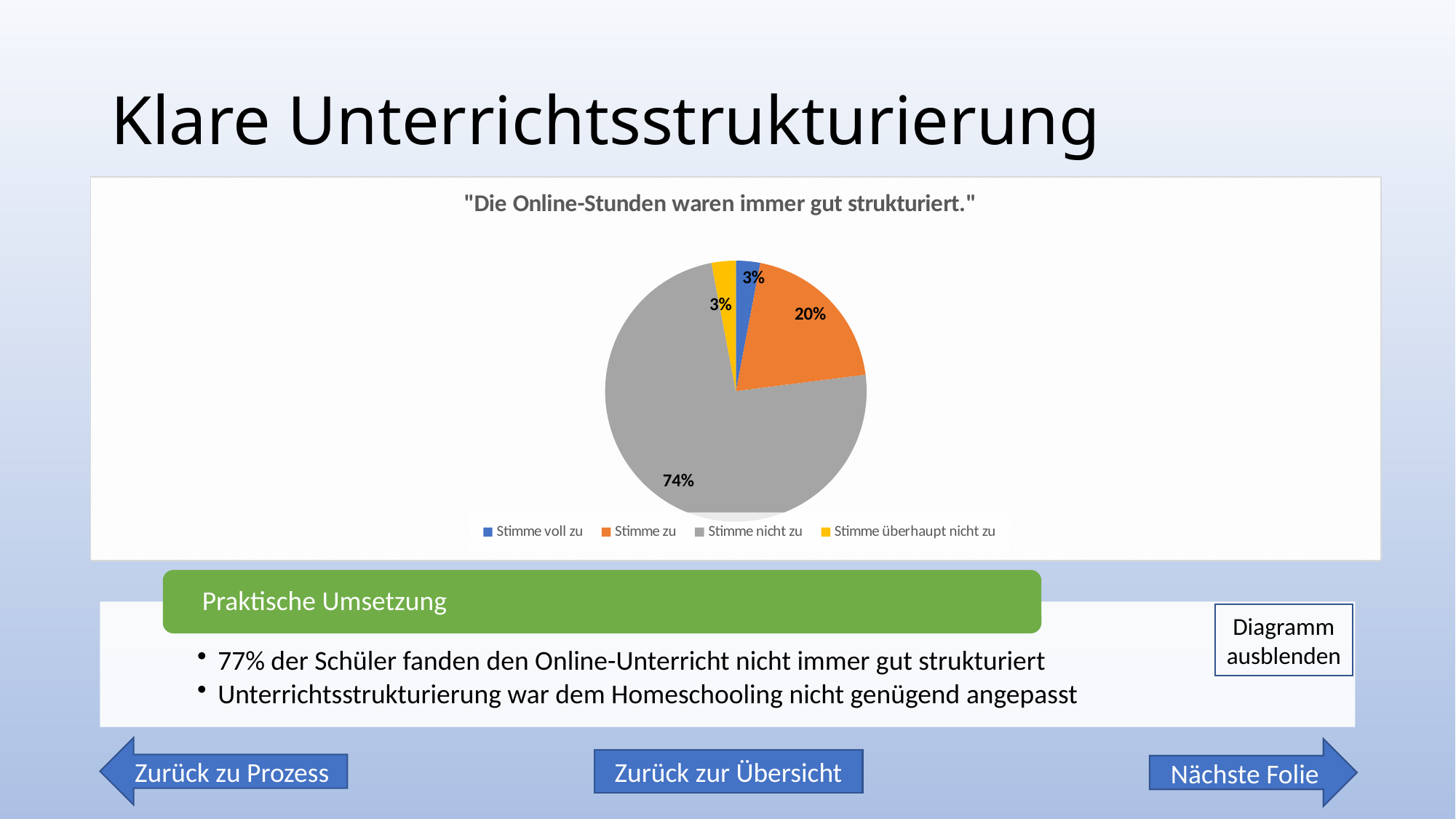
Which category has the largest slice of the pie? Stimme nicht zu What colour is the slice for "Stimme nicht zu"? grey What type of chart is shown on the slide? pie chart What share of the pie does "Stimme überhaupt nicht zu" have? 3% What is the title of the chart? "Die Online-Stunden waren immer gut strukturiert." Which is larger, the share for "Stimme zu" or the share for "Stimme voll zu"? Stimme zu What is the combined share of "Stimme voll zu" and "Stimme zu"? 23% What share of the pie does "Stimme zu" have? 20% How many categories does the legend list? 4 What share of the pie does "Stimme nicht zu" have? 74% What is the difference between the shares of "Stimme nicht zu" and "Stimme zu"? 54%